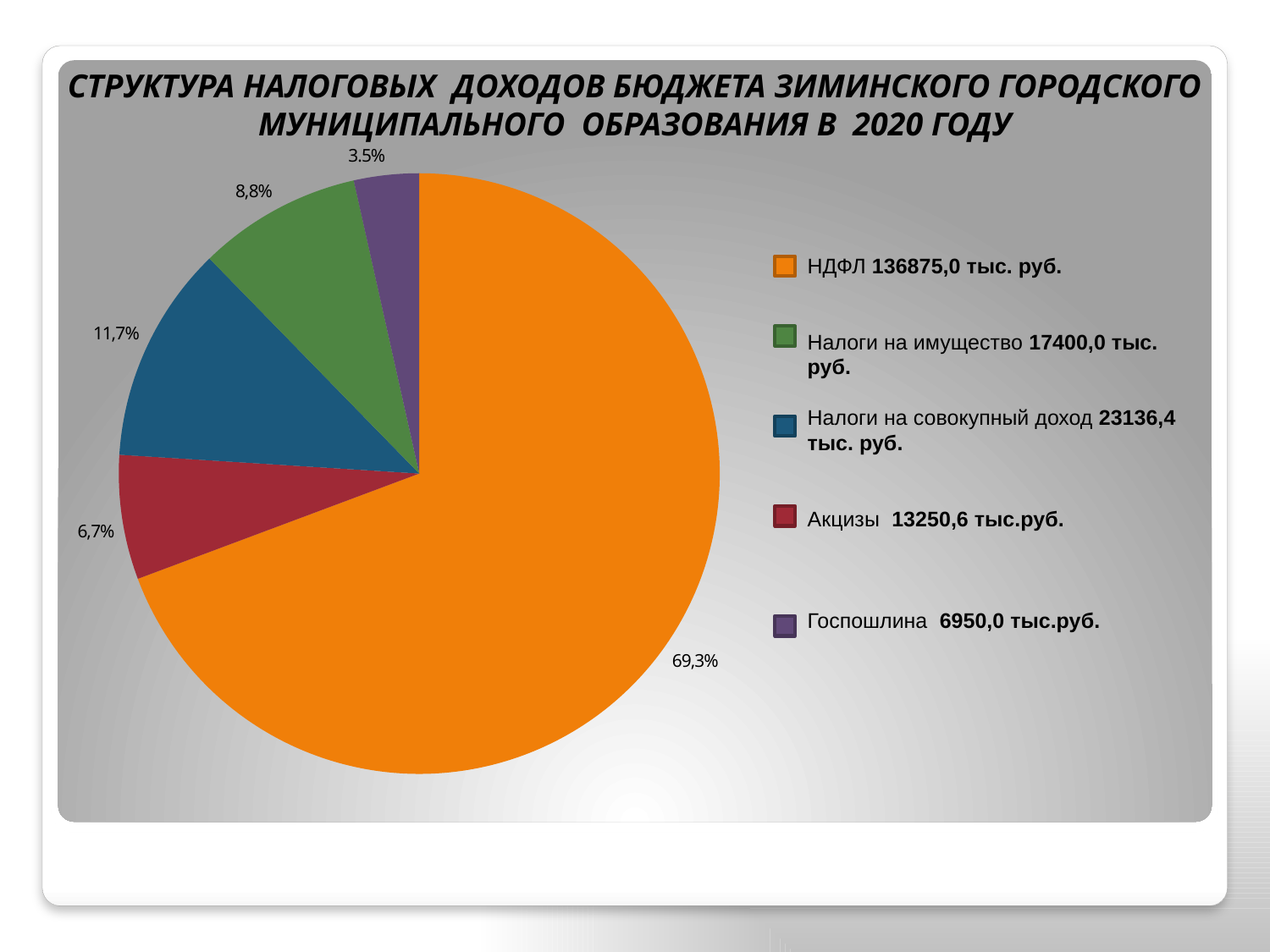
What share of the pie does Акцизы account for? 6,7% Which category has the smallest slice of the pie? Госпошлина According to the legend, what is the amount for Акцизы? 13250,6 тыс.руб. Which category has the largest slice of the pie? НДФЛ What colour is the slice for Налоги на совокупный доход? blue Which slice is larger: Налоги на имущество or Акцизы? Налоги на имущество What share of the pie does Налоги на совокупный доход account for? 11,7% What kind of chart is shown on the slide? pie chart What share of the pie does Госпошлина account for? 3.5% How many categories does the pie chart show? 5